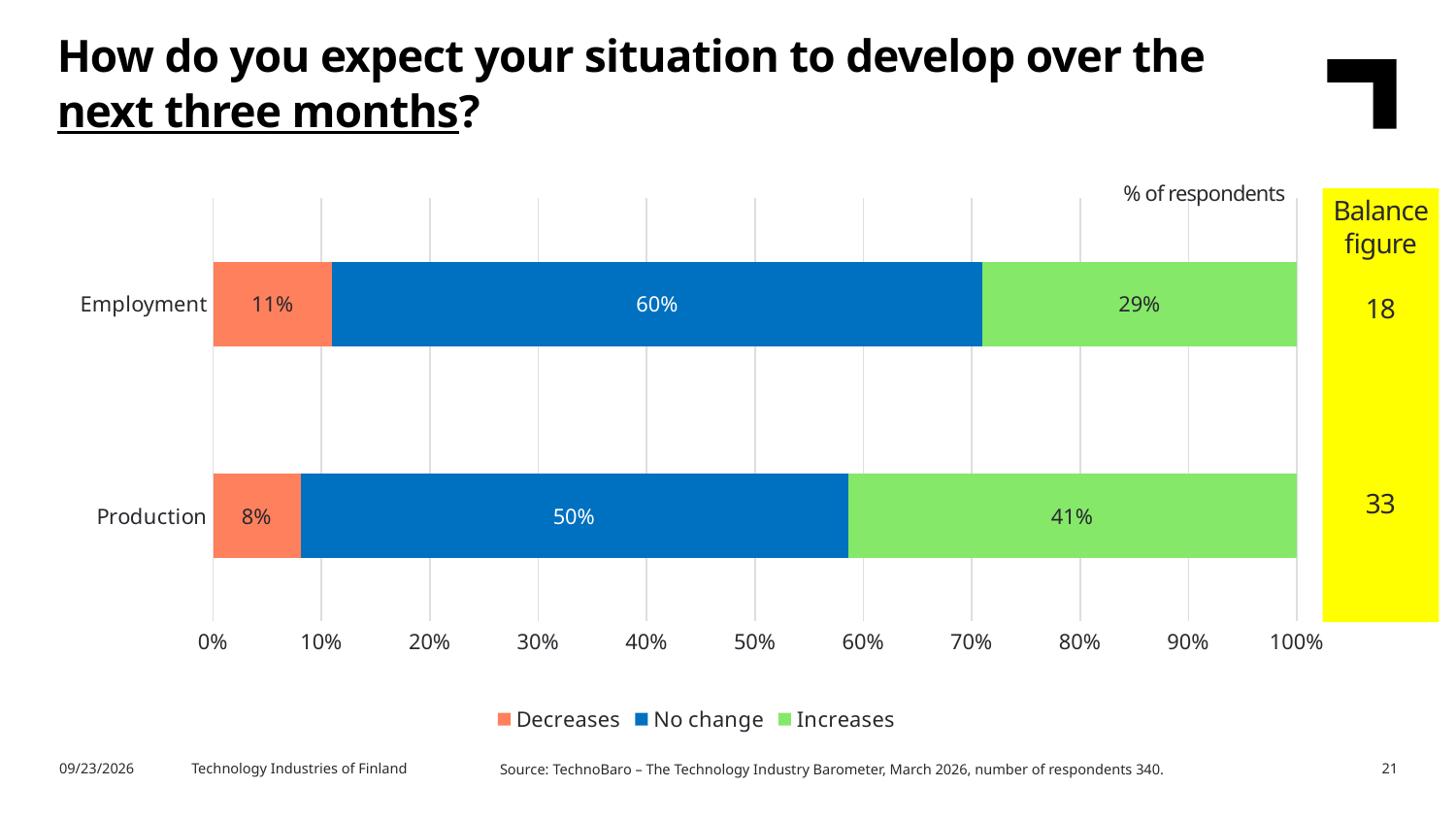
What percentage of respondents expect Production to increase? 41% How many series does the legend list? 3 Which series is shown in green in the legend? Increases What is the difference between the 'No change' shares for Employment and Production? 10 percentage points How many categories are shown on the chart? 2 What kind of chart is shown on the slide? Stacked bar chart What is the difference between the 'Increases' shares for Production and Employment? 12 percentage points What percentage of respondents expect Employment to decrease? 11% Which category has the larger share of respondents expecting increases, Employment or Production? Production What is the balance figure shown for Production? 33 What percentage of respondents expect no change in Employment? 60% What is the total of the stacked bar for Production? 99%